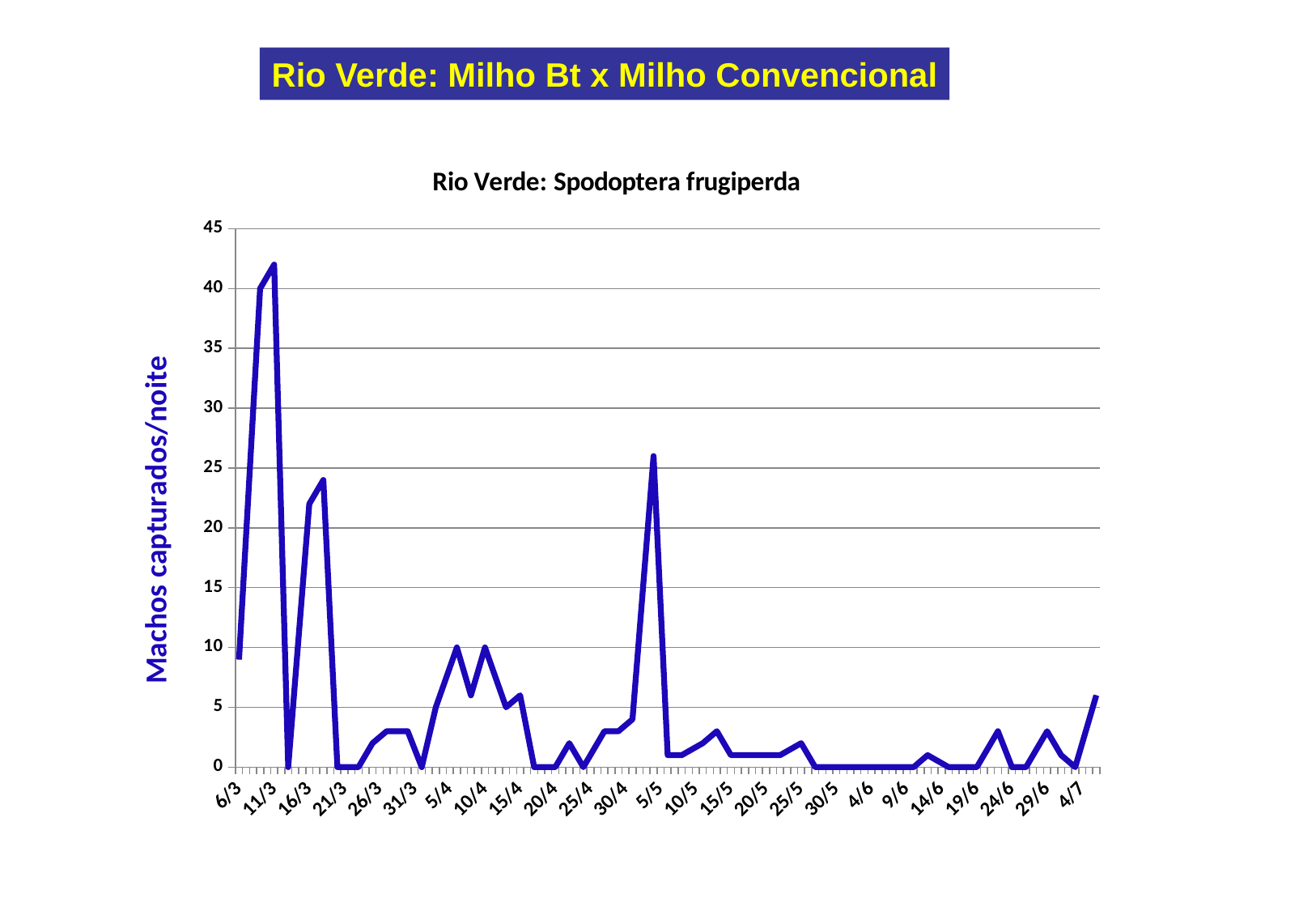
Around which date on the x axis does the line reach its highest value? 11/3 What is the value at 21/3? 0 What kind of chart is shown on the slide? line chart What is the title of the chart? Rio Verde: Spodoptera frugiperda Does the line rise or fall between 6/3 and 11/3? rise Is the peak value near 11/3 greater or less than 40? greater Is the peak value near 16/3 greater or less than 25? less What is the label on the vertical axis of the chart? Machos capturados/noite Which is larger, the peak near 11/3 or the peak near 5/5? the peak near 11/3 Which is larger, the peak near 5/4 or the peak near 5/5? the peak near 5/5 Is the peak value near 5/5 greater or less than 25? greater